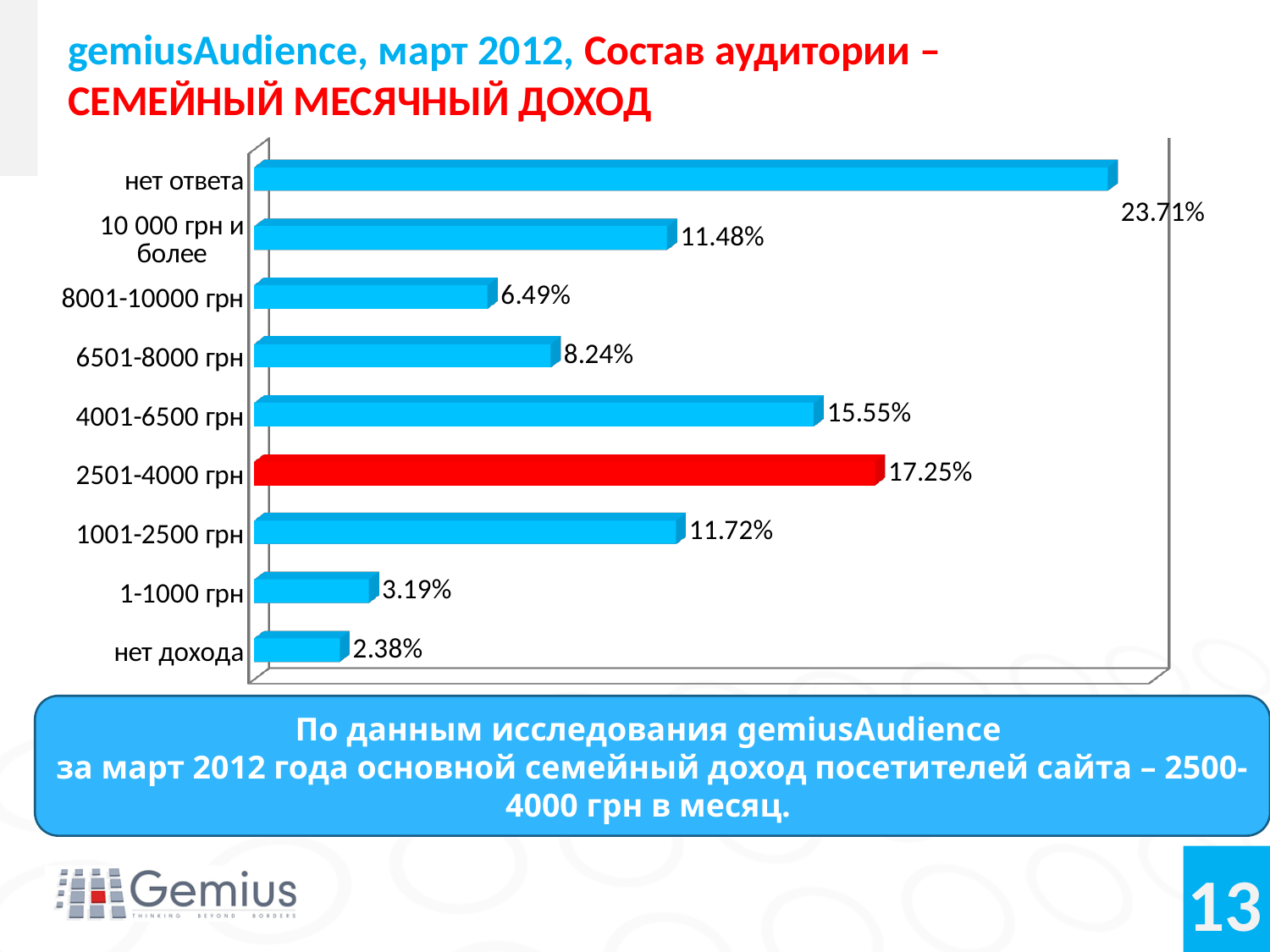
What kind of chart is shown on the slide? bar chart How many categories are shown in the chart? 9 What is the value for the category "2501-4000 грн"? 17.25% What is the difference between the values for "1001-2500 грн" and "10 000 грн и более"? 0.24% Which category's bar is coloured red instead of blue? 2501-4000 грн What is the value for the category "нет ответа"? 23.71% Which category has the lowest value? нет дохода What is the difference between the values for "2501-4000 грн" and "4001-6500 грн"? 1.70% Which is larger, the value for "6501-8000 грн" or the value for "8001-10000 грн"? 6501-8000 грн What is the value for the category "8001-10000 грн"? 6.49% What is the value for the category "1-1000 грн"? 3.19% Which category has the highest value? нет ответа